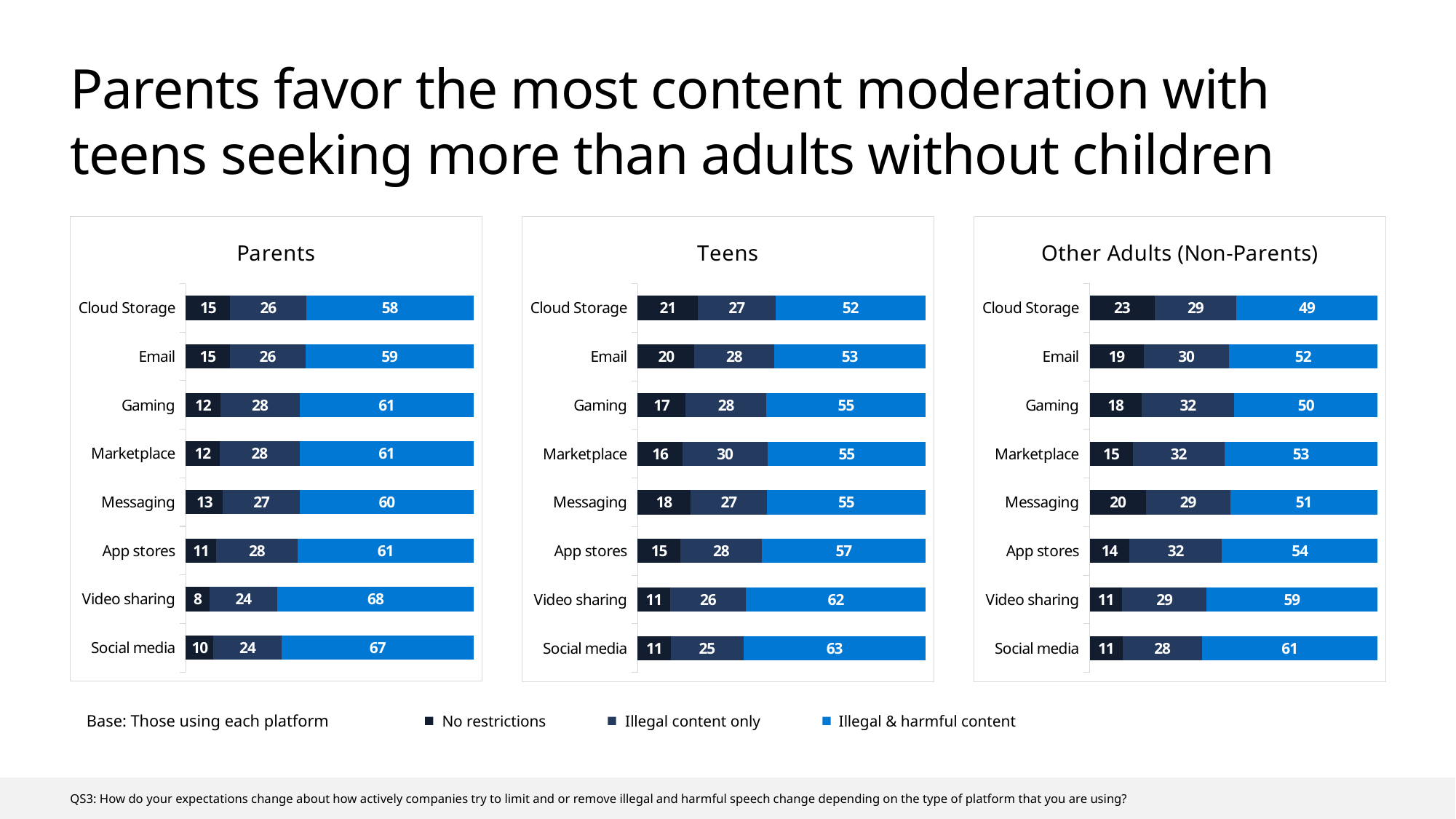
In the Other Adults (Non-Parents) chart, which platform has the lowest value for Illegal & harmful content? Cloud Storage How many platforms are listed in the Teens chart? 8 In the Other Adults (Non-Parents) chart, what is the value for Illegal content only for Gaming? 32 In the Other Adults (Non-Parents) chart, what is the total of the stacked bar for Email? 101 In the Teens chart, what is the value for No restrictions for Cloud Storage? 21 What kind of chart is the Parents chart? Stacked bar chart In the Parents chart, which is larger: the No restrictions value for Cloud Storage or for Social media? Cloud Storage In the Parents chart, which platform has the highest value for Illegal & harmful content? Video sharing In the Teens chart, what is the difference between the Illegal & harmful content values for Social media and Cloud Storage? 11 What is the title of the chart on the right of the slide? Other Adults (Non-Parents) How many series does the legend list? 3 In the Parents chart, what is the value for Illegal & harmful content for Video sharing? 68